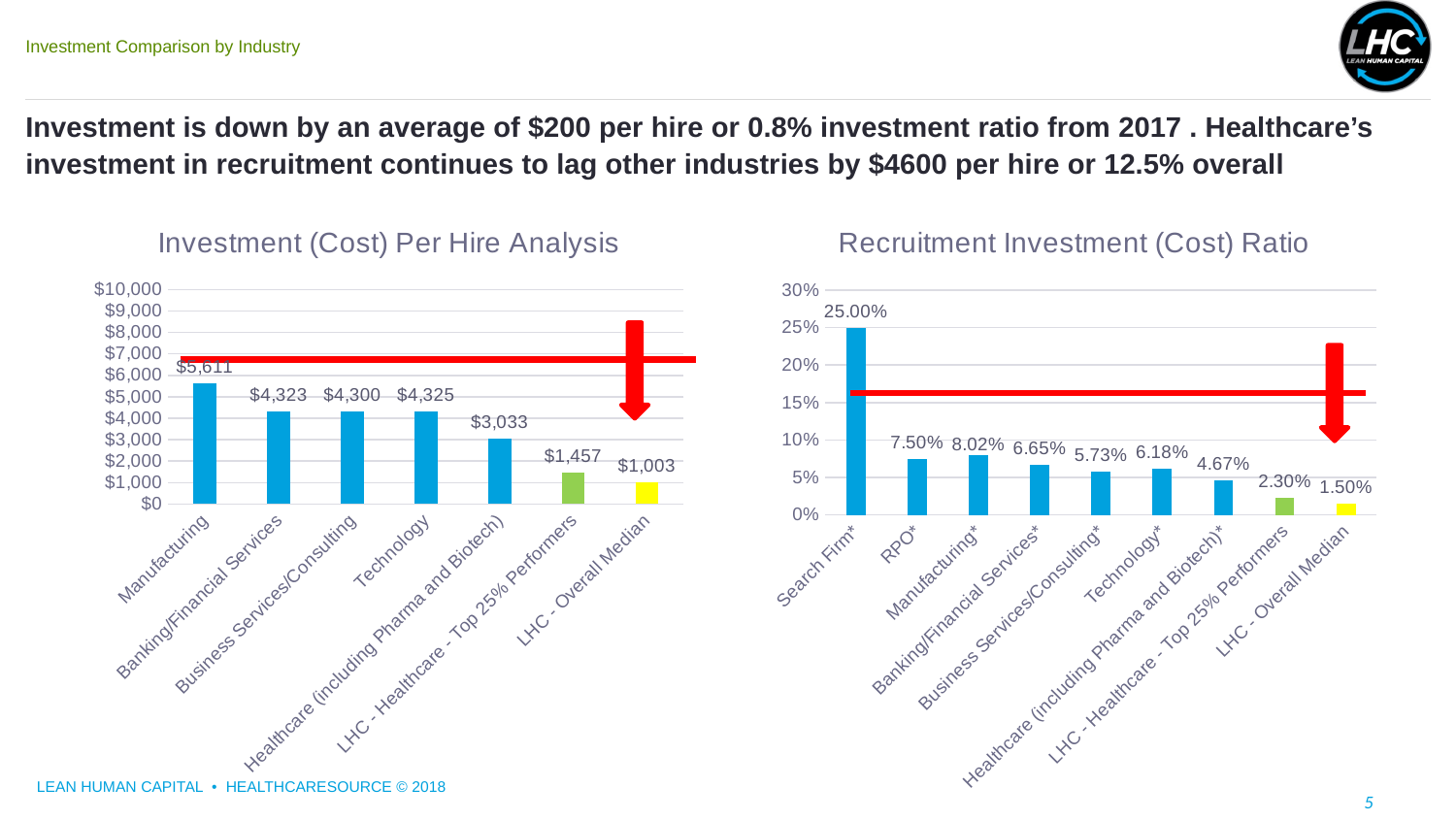
In the Recruitment Investment (Cost) Ratio chart, which is larger, Manufacturing* or RPO*? Manufacturing* In the Recruitment Investment (Cost) Ratio chart, what is the value for Healthcare (including Pharma and Biotech)*? 4.67% In the Investment (Cost) Per Hire Analysis chart, what is the value for Manufacturing? $5,611 In the Recruitment Investment (Cost) Ratio chart, which category has the highest value? Search Firm* In the Investment (Cost) Per Hire Analysis chart, how many categories are shown? 7 What kind of chart is the Investment (Cost) Per Hire Analysis chart? Bar chart In the Recruitment Investment (Cost) Ratio chart, how many categories are shown? 9 In the Investment (Cost) Per Hire Analysis chart, what is the difference between Manufacturing and Healthcare (including Pharma and Biotech)? $2,578 In the Investment (Cost) Per Hire Analysis chart, what is the value for Healthcare (including Pharma and Biotech)? $3,033 In the Recruitment Investment (Cost) Ratio chart, what is the difference between LHC - Healthcare - Top 25% Performers and LHC - Overall Median? 0.80% In the Investment (Cost) Per Hire Analysis chart, which category has the lowest value? LHC - Overall Median In the Recruitment Investment (Cost) Ratio chart, what is the value for Search Firm*? 25.00%